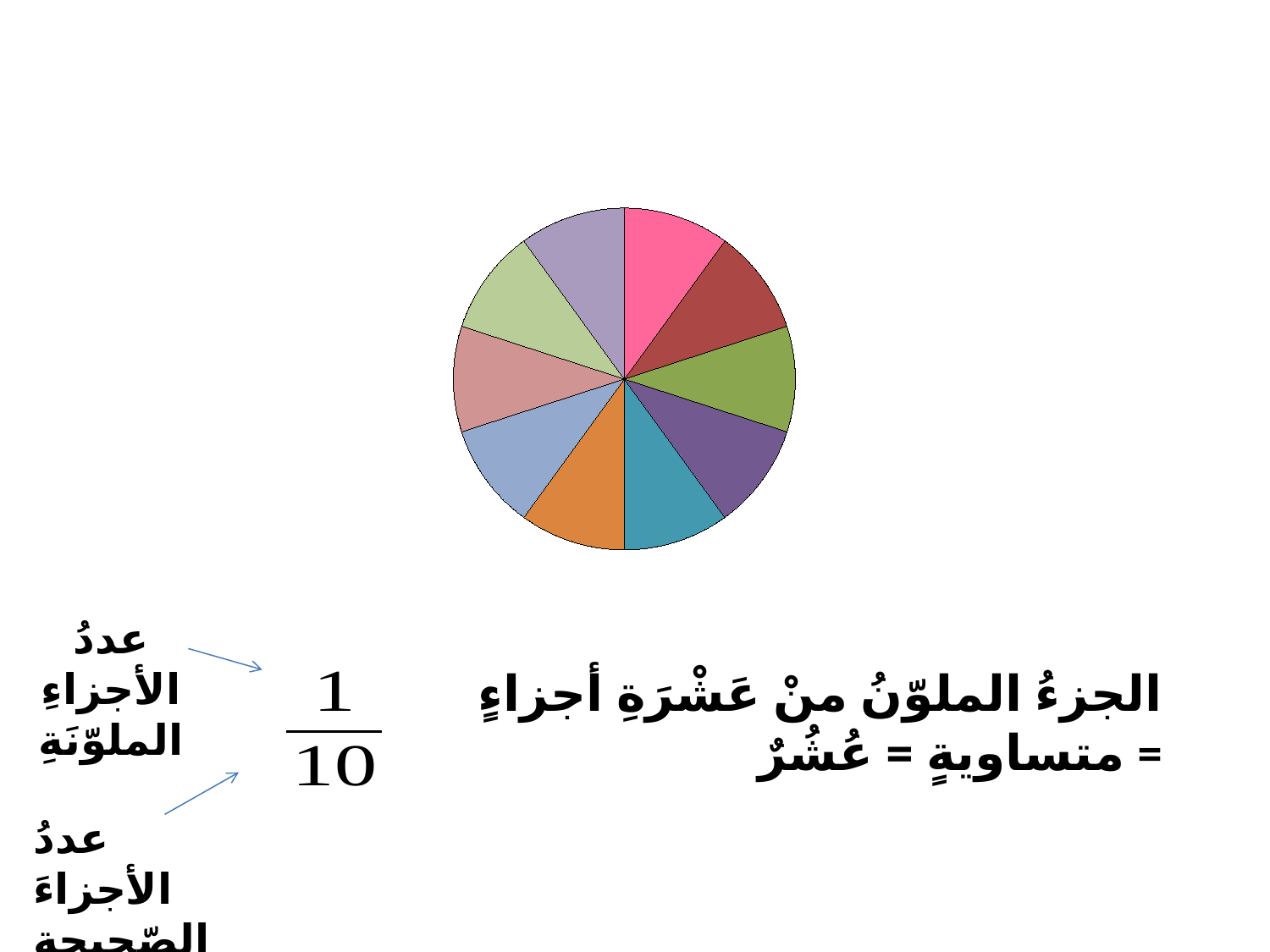
According to the slide, what fraction of the whole pie does one slice represent? 1/10 How many slices does the pie chart have? 10 What kind of chart is shown on the slide? pie chart Does the pie chart have a legend? No Are the slices of the pie chart equal in size or different in size? equal